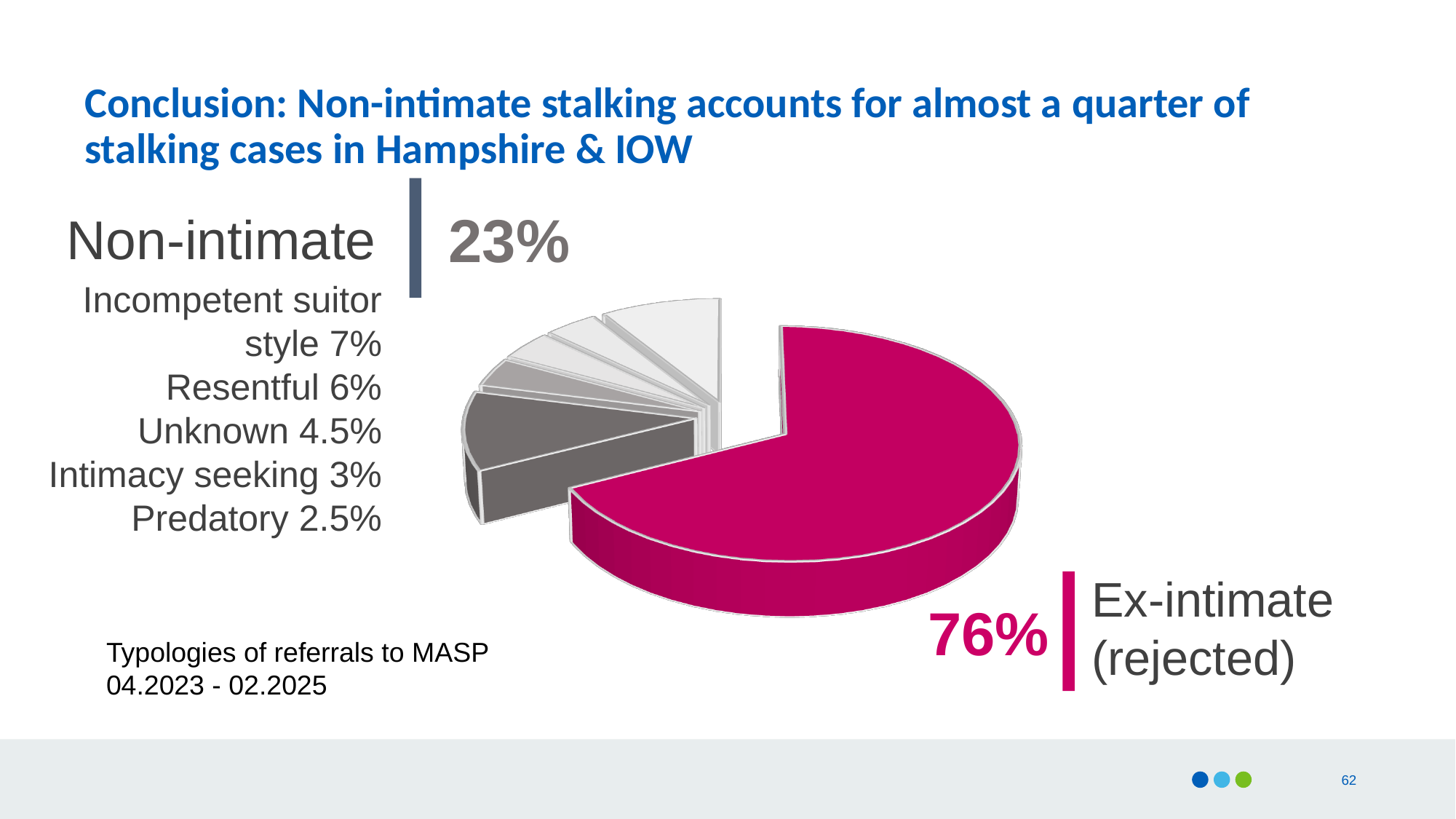
What percentage is shown for Unknown? 4.5% What percentage is shown for Predatory? 2.5% Which category has the largest share of the pie? Ex-intimate (rejected) What percentage is shown for Resentful? 6% Which of the listed non-intimate typologies has the smallest percentage? Predatory How many non-intimate typologies are listed with percentages? 5 What colour is the Ex-intimate (rejected) slice? Magenta What kind of chart is shown on the slide? Pie chart What share of referrals is Ex-intimate (rejected)? 76% What share of referrals is Non-intimate? 23% What is the difference in percentage points between Ex-intimate (rejected) and Non-intimate? 53 Which is larger, Incompetent suitor style or Intimacy seeking? Incompetent suitor style